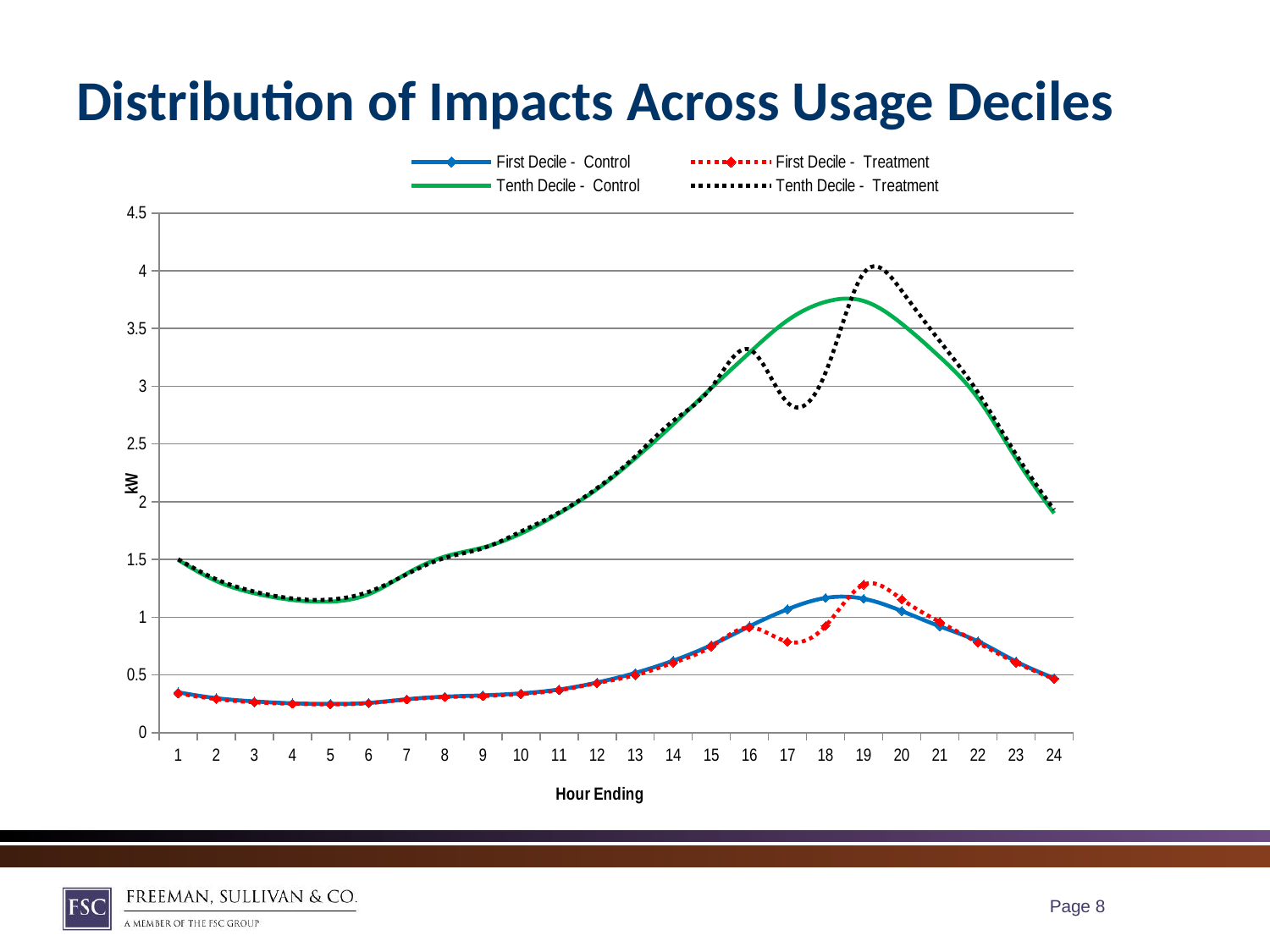
Is the value for Tenth Decile - Control at hour 18 greater or less than 3.5? greater How many series does the legend list? 4 What is the label of the x axis? Hour Ending What is the title of the slide's chart? Distribution of Impacts Across Usage Deciles Is the value for First Decile - Treatment at hour 19 greater or less than 1? greater How many hours are plotted along the x axis? 24 At hour 17, which is higher: Tenth Decile - Control or Tenth Decile - Treatment? Tenth Decile - Control At which hour does the Tenth Decile - Treatment series reach its highest value? 19 Is the value for Tenth Decile - Treatment at hour 17 greater or less than 3? less What kind of chart is shown on the slide? line chart Does the Tenth Decile - Control series rise or fall from hour 19 to hour 24? fall